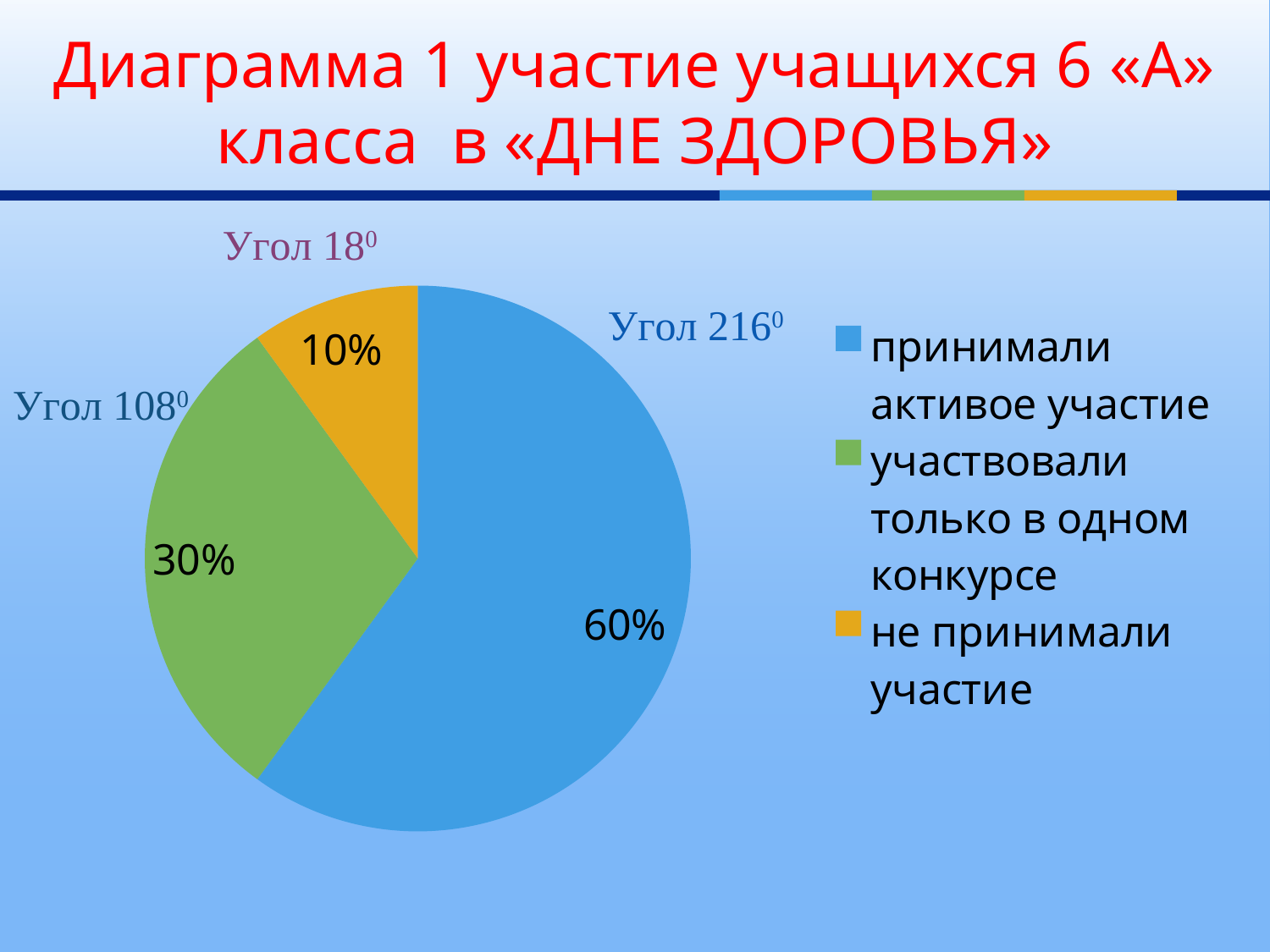
What angle is annotated next to the blue slice? Угол 216⁰ Which category has the smallest slice of the pie? не принимали участие What kind of chart is shown on the slide? pie chart Which category has the largest slice of the pie? принимали активное участие Which is larger: the slice for "участвовали только в одном конкурсе" or the slice for "не принимали участие"? участвовали только в одном конкурсе What percentage of the pie is labelled for "принимали активное участие"? 60% How many entries does the legend list? 3 What percentage of the pie is labelled for "участвовали только в одном конкурсе"? 30% What is the difference in percentage points between "принимали активное участие" and "участвовали только в одном конкурсе"? 30 What colour is the slice for "не принимали участие"? orange What percentage of the pie is labelled for "не принимали участие"? 10% How many slices does the pie chart have? 3